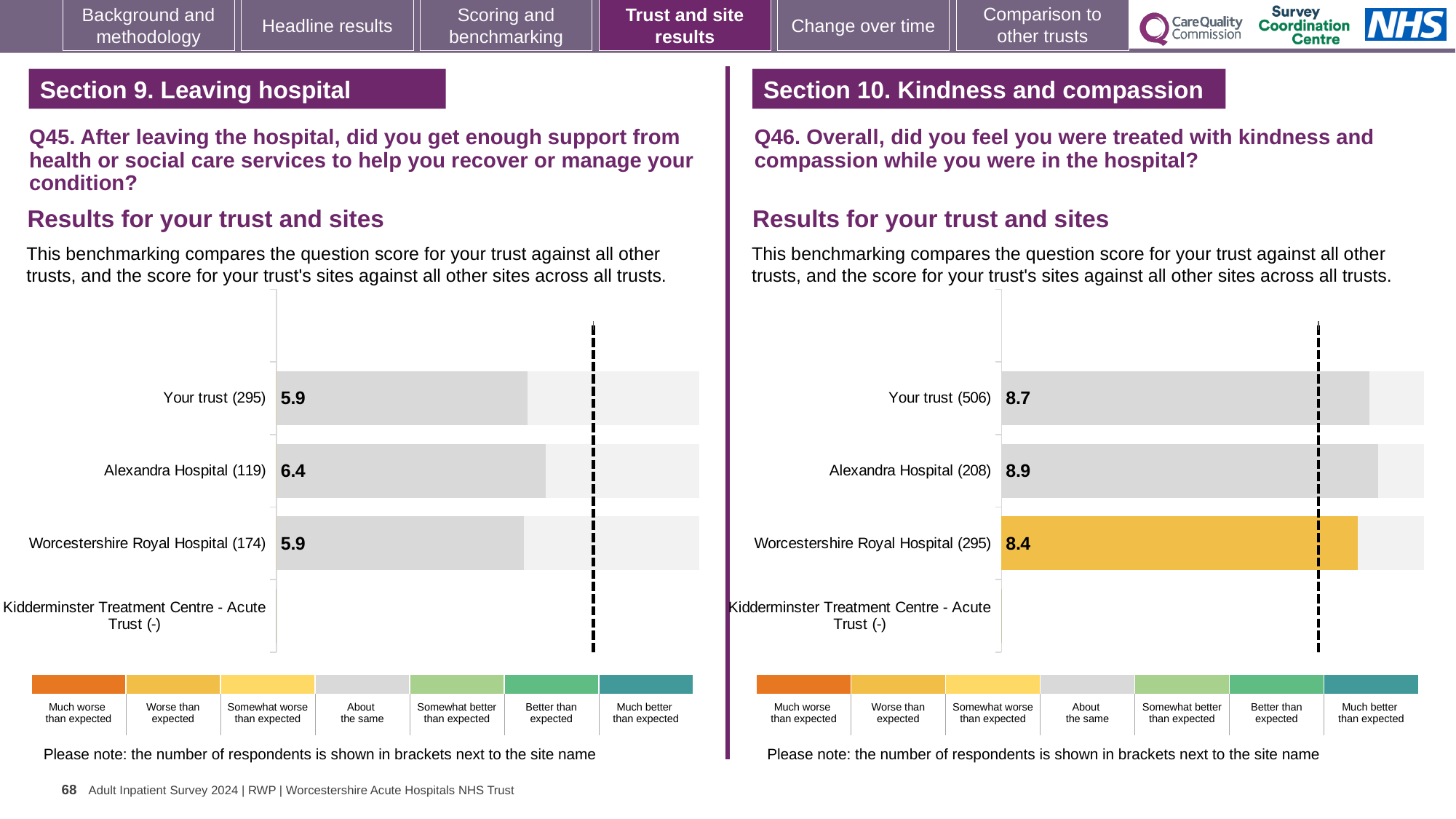
In the Q45 chart on the left, what is the score for Your trust? 5.9 In the Q45 chart on the left, which site or trust has the highest score? Alexandra Hospital In the Q46 chart on the right, which has the larger score: Your trust or Alexandra Hospital? Alexandra Hospital In the Q45 chart on the left, what is the difference between the scores for Alexandra Hospital and Your trust? 0.5 In the Q46 chart on the right, what is the score for Alexandra Hospital? 8.9 In the Q46 chart on the right, which site or trust has the lowest score? Worcestershire Royal Hospital In the Q46 chart on the right, what is the score for Worcestershire Royal Hospital? 8.4 In the Q45 chart on the left, what is the score for Alexandra Hospital? 6.4 In the Q46 chart on the right, which site's bar is coloured yellow/orange rather than grey? Worcestershire Royal Hospital In the Q46 chart on the right, what is the difference between the scores for Alexandra Hospital and Worcestershire Royal Hospital? 0.5 What kind of chart is used for the Q45 results on the left? Bar chart How many respondents are shown in brackets for Your trust in the Q46 chart on the right? 506